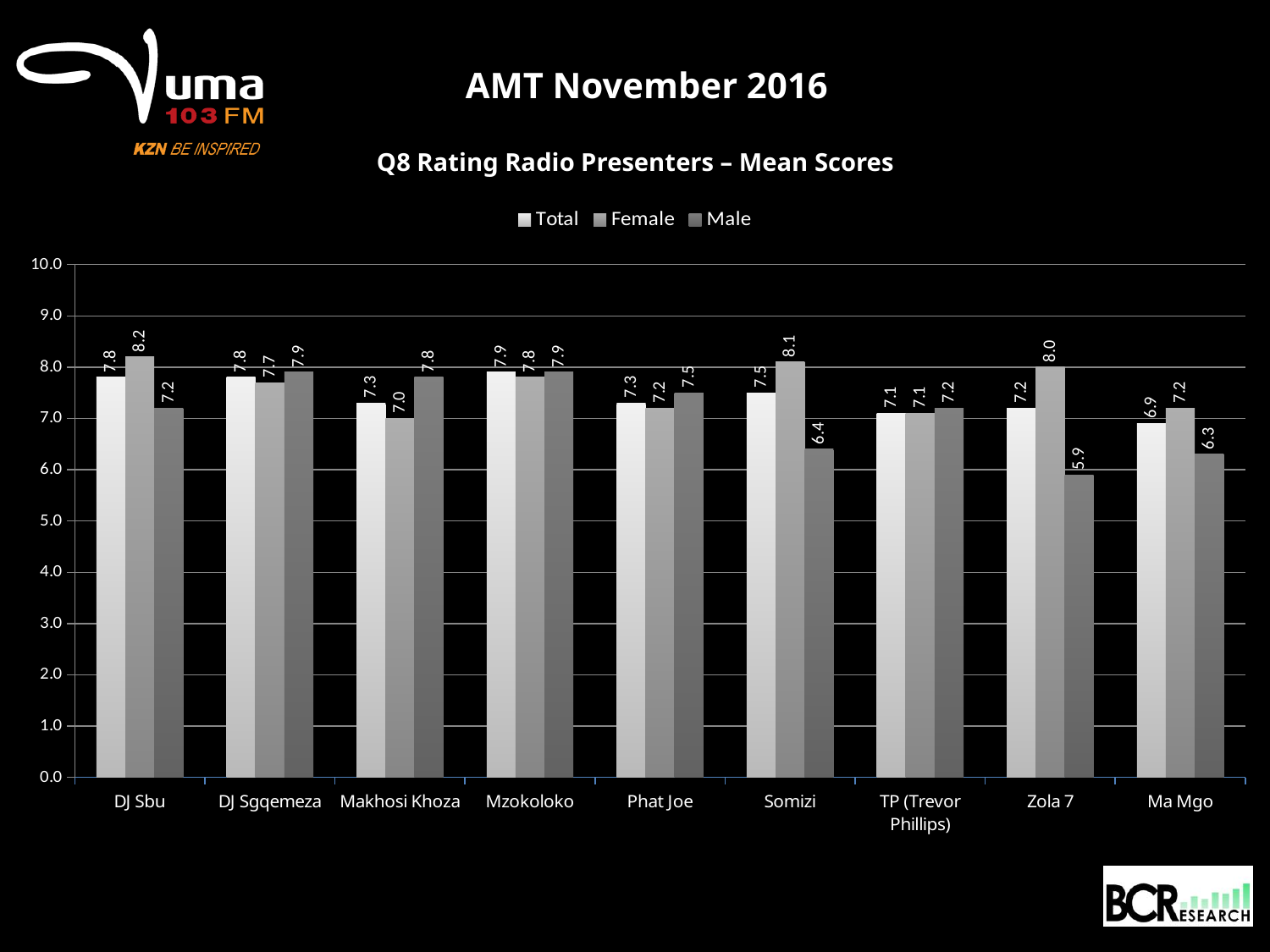
What type of chart is shown on the slide? bar chart Is the Male mean score for Somizi higher or lower than the Male mean score for Makhosi Khoza? lower How many series does the legend list? 3 Which presenter has the highest Total mean score? Mzokoloko How many presenters are shown on the x axis? 9 Which presenter has the highest Female mean score? DJ Sbu What is the Total mean score for Ma Mgo? 6.9 What is the Female mean score for DJ Sbu? 8.2 What is the Male mean score for Zola 7? 5.9 Which presenter has the lowest Male mean score? Zola 7 What is the title of the chart? Q8 Rating Radio Presenters – Mean Scores What is the difference between the Female and Male mean scores for Somizi? 1.7